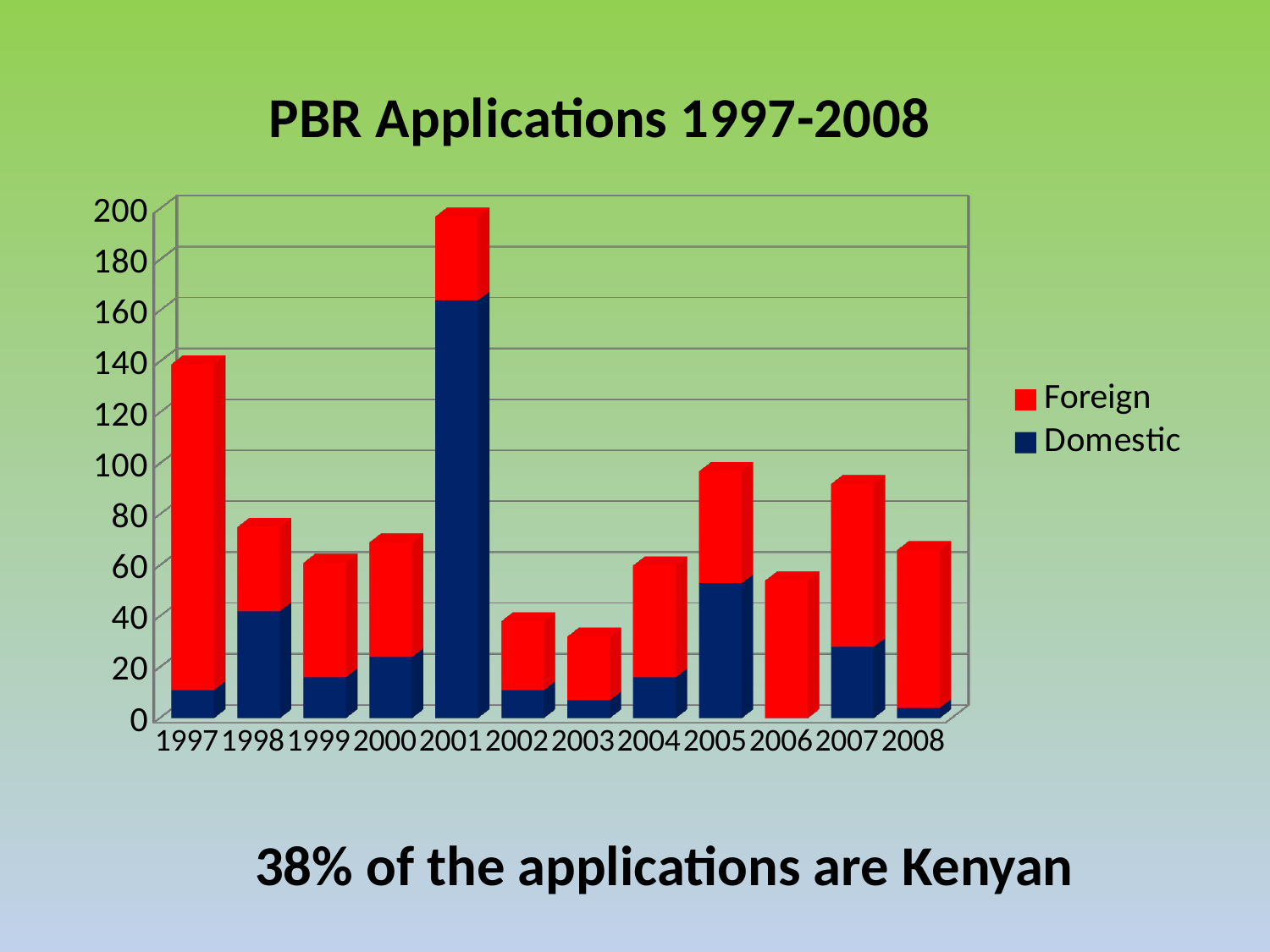
How many series does the legend list? 2 Which year has the larger total, 1997 or 2005? 1997 How many years are shown on the x axis? 12 Is the total value for 1997 greater or less than 120? greater Is the total value for 2003 greater or less than 40? less Which year has the lowest total number of applications? 2003 Which colour represents the Foreign series in the legend? Red What kind of chart is shown on the slide? Stacked bar chart Is the total value for 2001 greater or less than 180? greater Which year has the highest total number of applications? 2001 What is the title of the chart? PBR Applications 1997-2008 Which year has the largest Domestic segment? 2001